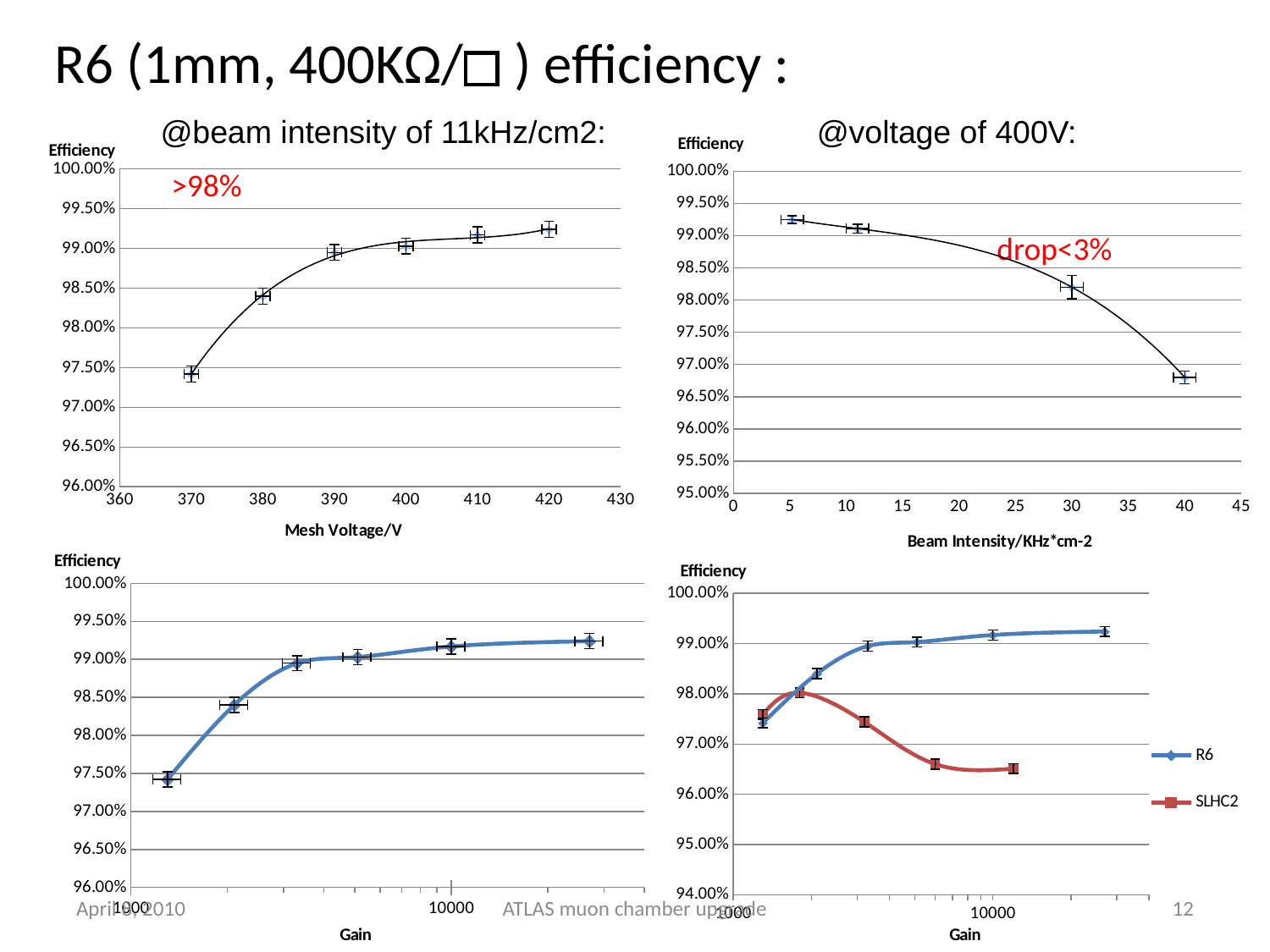
On the bottom-right chart (Efficiency vs Gain), how many series does the legend list? 2 On the top-right chart (Efficiency vs Beam Intensity/KHz*cm-2), do the efficiency values rise or fall as beam intensity increases? fall On the top-left chart (Efficiency vs Mesh Voltage/V), is the efficiency at 380 V greater or less than 98.00%? greater On the top-left chart (Efficiency vs Mesh Voltage/V), how many data points are plotted? 6 What kind of chart is the bottom-left chart (Efficiency vs Gain)? line chart On the top-right chart (Efficiency vs Beam Intensity/KHz*cm-2), is the efficiency at a beam intensity of 40 greater or less than 97.00%? less On the top-left chart (Efficiency vs Mesh Voltage/V), is the efficiency at 420 V greater or less than 99.00%? greater On the top-left chart (Efficiency vs Mesh Voltage/V), at which mesh voltage is the efficiency lowest? 370 On the top-left chart (Efficiency vs Mesh Voltage/V), do the efficiency values rise or fall as mesh voltage increases? rise On the top-right chart (Efficiency vs Beam Intensity/KHz*cm-2), how many data points are plotted? 4 On the bottom-right chart (Efficiency vs Gain), which series has the higher efficiency at a gain of 10000, R6 or SLHC2? R6